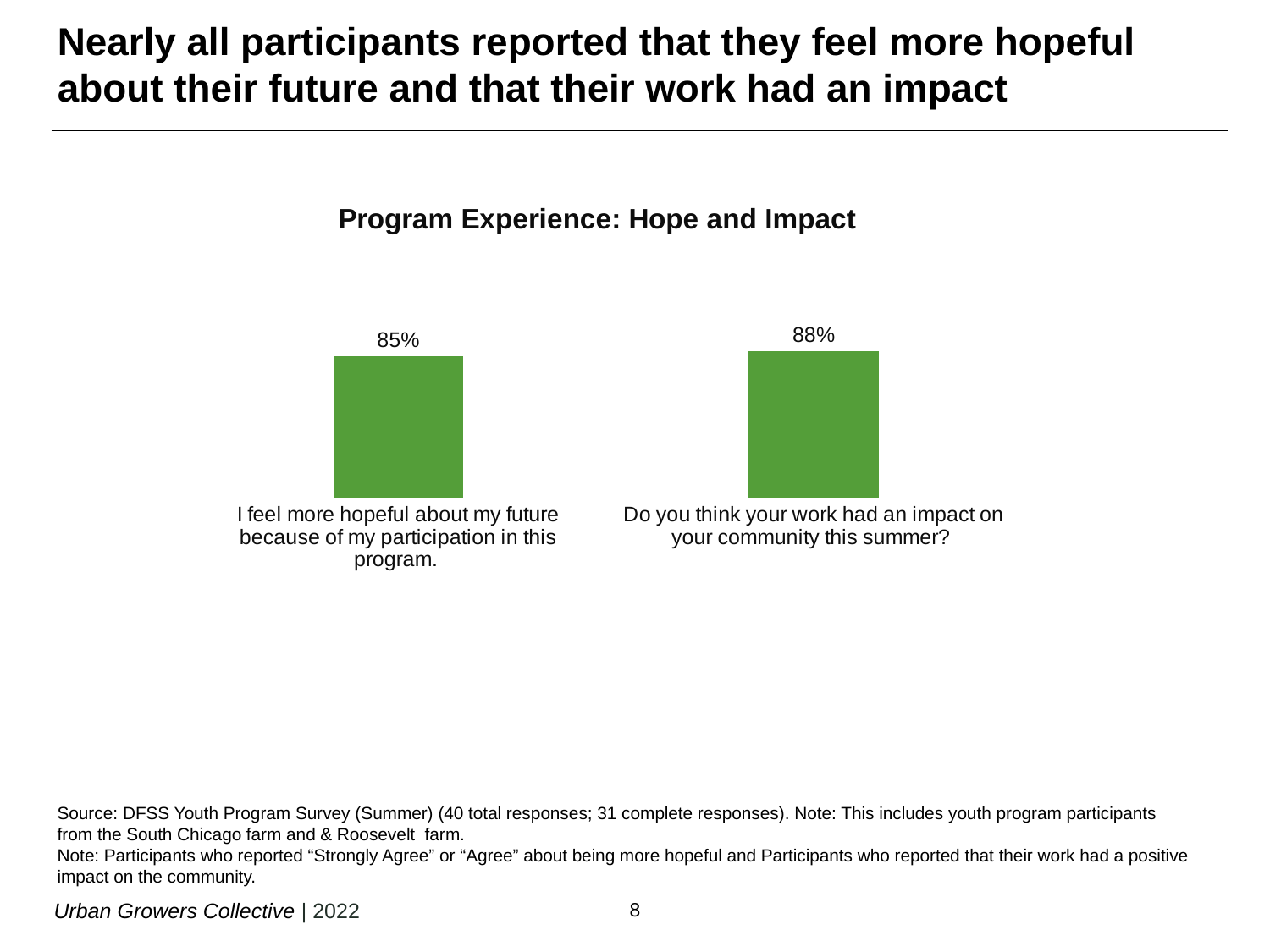
Which category has the higher value: feeling more hopeful about the future, or thinking their work had an impact on the community? Do you think your work had an impact on your community this summer? What type of chart is shown on the slide? Bar chart What is the difference in percentage points between the 'work had an impact' value and the 'more hopeful' value? 3 percentage points What percentage of participants think their work had an impact on their community this summer? 88% What is the title of the chart? Program Experience: Hope and Impact What percentage of participants said they feel more hopeful about their future because of their participation in the program? 85% How many categories are shown in the chart? 2 What colour are the bars in the chart? Green Is the value for 'I feel more hopeful about my future' larger or smaller than the value for 'Do you think your work had an impact on your community'? smaller Which category has the lower value in the chart? I feel more hopeful about my future because of my participation in this program.